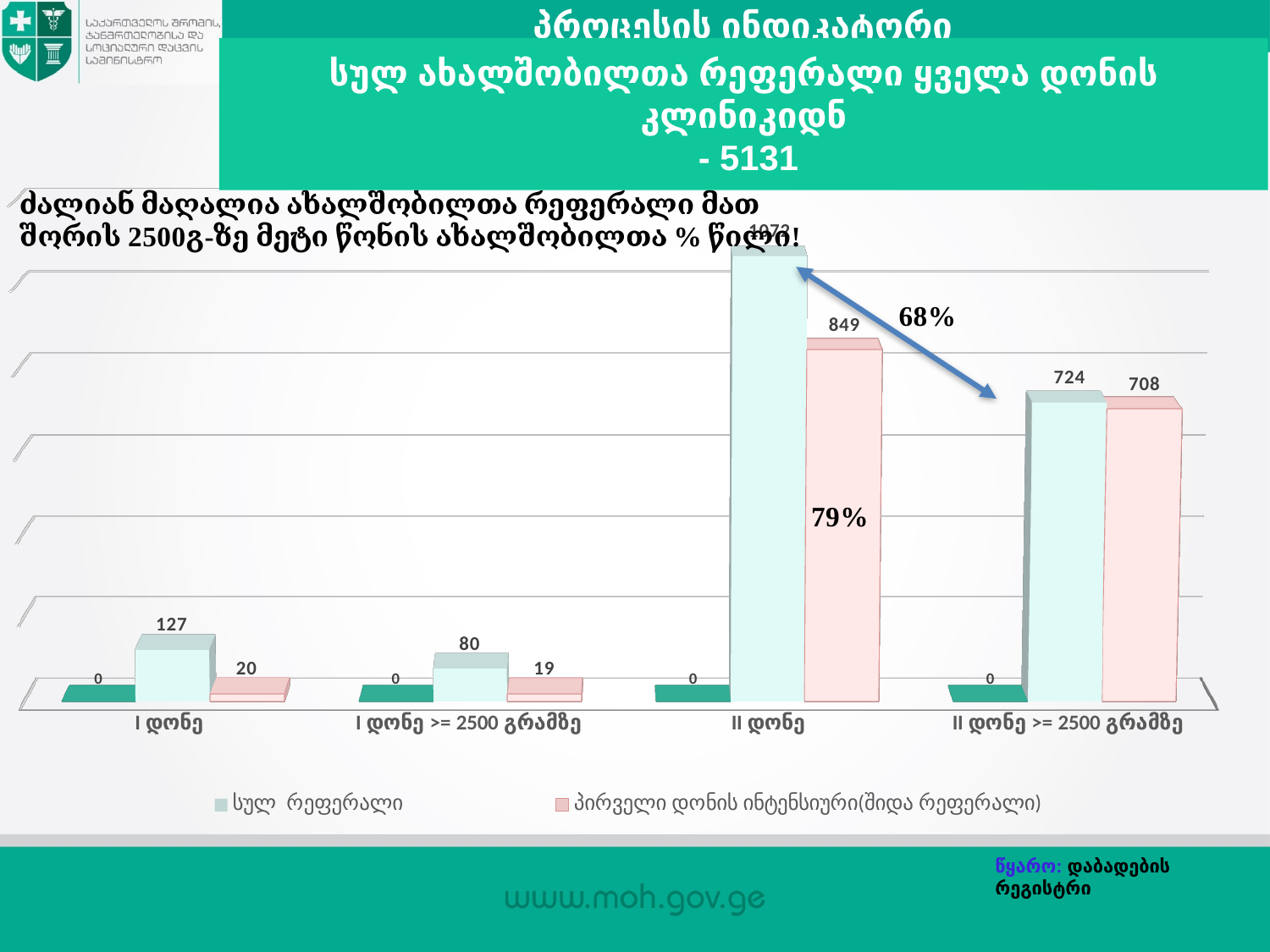
What is the value of პირველი დონის ინტენსიური(შიდა რეფერალი) for II დონე? 849 How many categories are shown on the x axis of the chart? 4 How many series does the chart legend list? 2 What kind of chart is shown on the slide? Bar chart Which category has the highest value for პირველი დონის ინტენსიური(შიდა რეფერალი)? II დონე Which category has the lowest value for პირველი დონის ინტენსიური(შიდა რეფერალი)? I დონე >= 2500 გრამზე What is the value of პირველი დონის ინტენსიური(შიდა რეფერალი) for II დონე >= 2500 გრამზე? 708 What is the value of პირველი დონის ინტენსიური(შიდა რეფერალი) for I დონე? 20 What is the difference between სულ რეფერალი and პირველი დონის ინტენსიური(შიდა რეფერალი) for II დონე >= 2500 გრამზე? 16 What is the value of სულ რეფერალი for I დონე >= 2500 გრამზე? 80 What is the value of სულ რეფერალი for I დონე? 127 What is the value of სულ რეფერალი for II დონე >= 2500 გრამზე? 724